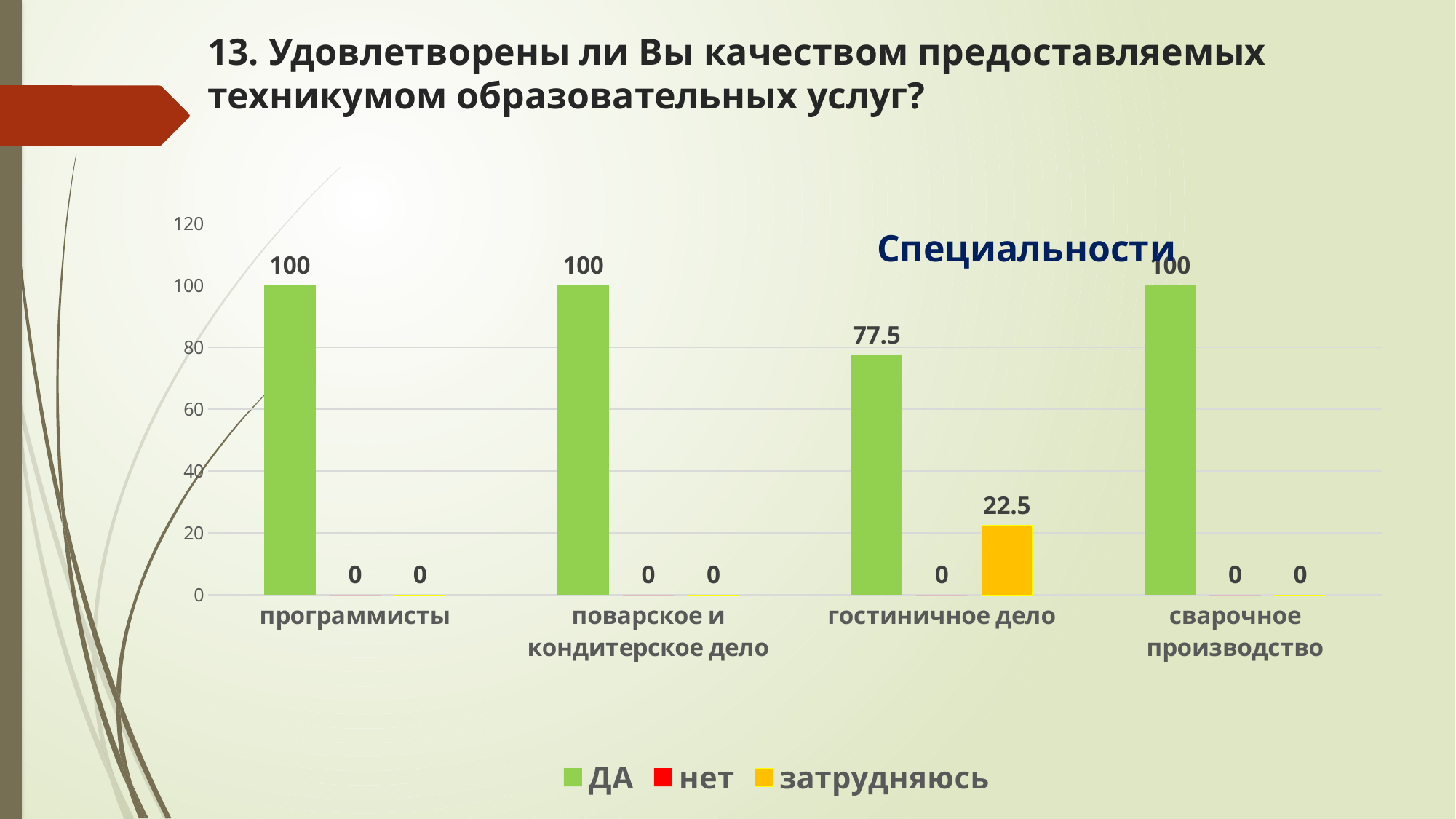
What is the value of the ДА series for гостиничное дело? 77.5 What is the value of the затрудняюсь series for гостиничное дело? 22.5 What colour are the bars for the ДА series? green What is the value of the ДА series for программисты? 100 How many categories are shown on the x axis? 4 What is the value of the нет series for сварочное производство? 0 Which category has the highest value for the затрудняюсь series? гостиничное дело Which is larger for гостиничное дело: the ДА value or the затрудняюсь value? ДА How many series does the legend list? 3 Which category has the lowest value for the ДА series? гостиничное дело What is the difference between the ДА value for поварское и кондитерское дело and the ДА value for гостиничное дело? 22.5 What kind of chart is shown on the slide? bar chart